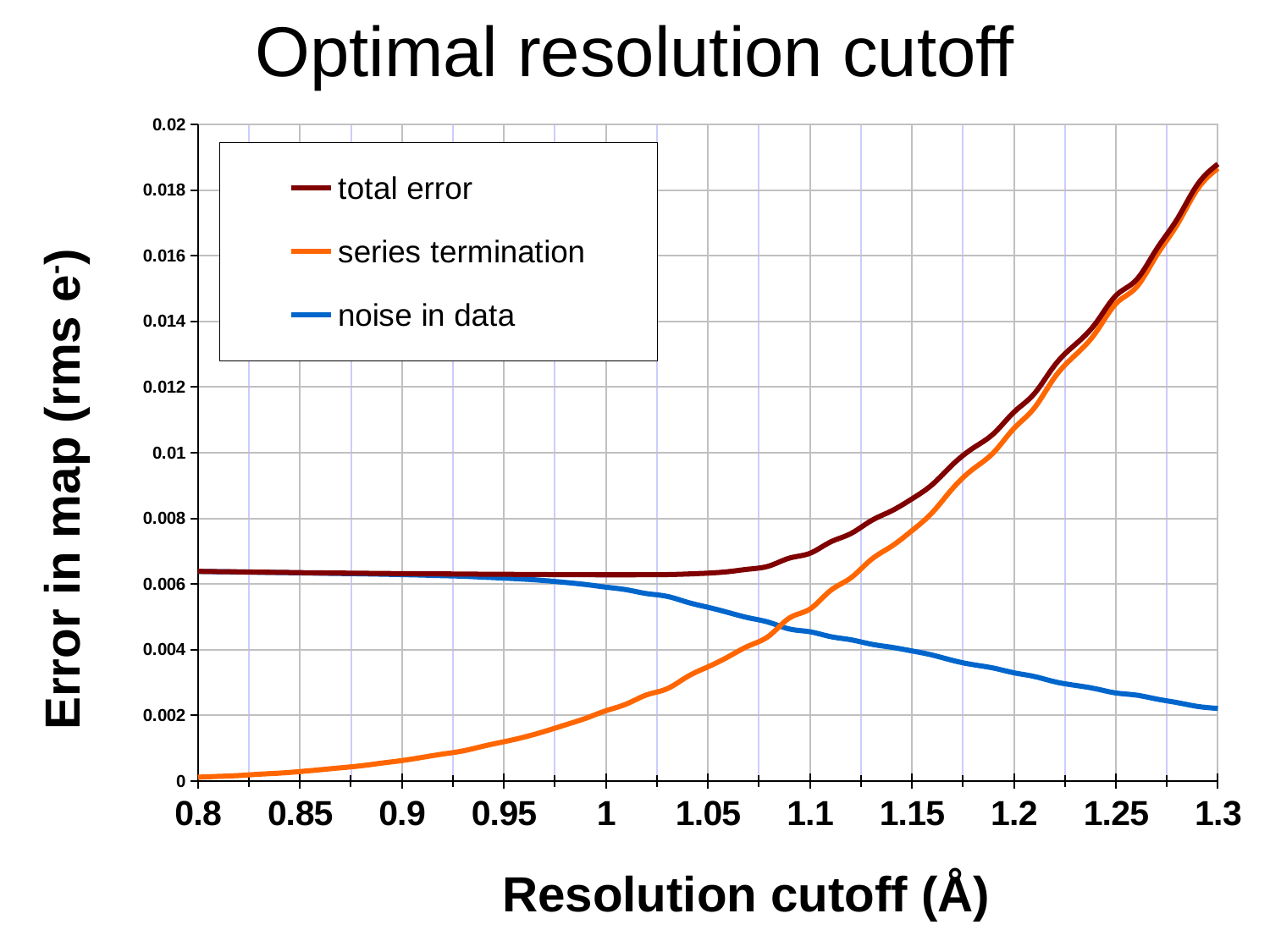
Which series has the lowest value at a resolution cutoff of 1.3? noise in data What is the title of the chart? Optimal resolution cutoff How many series does the legend list? 3 Does the 'noise in data' line rise or fall as the resolution cutoff increases from 0.8 to 1.3? fall At a resolution cutoff of 0.8, which is higher: 'noise in data' or 'series termination'? noise in data Does the 'series termination' line rise or fall as the resolution cutoff increases from 0.8 to 1.3? rise What kind of chart is shown on the slide? line chart Is the value of 'noise in data' at a resolution cutoff of 1.3 greater or less than 0.004? less Is the value of 'total error' at a resolution cutoff of 0.8 greater or less than 0.008? less Is the value of 'series termination' at a resolution cutoff of 0.8 greater or less than 0.002? less At a resolution cutoff of 1.3, which is higher: 'series termination' or 'noise in data'? series termination